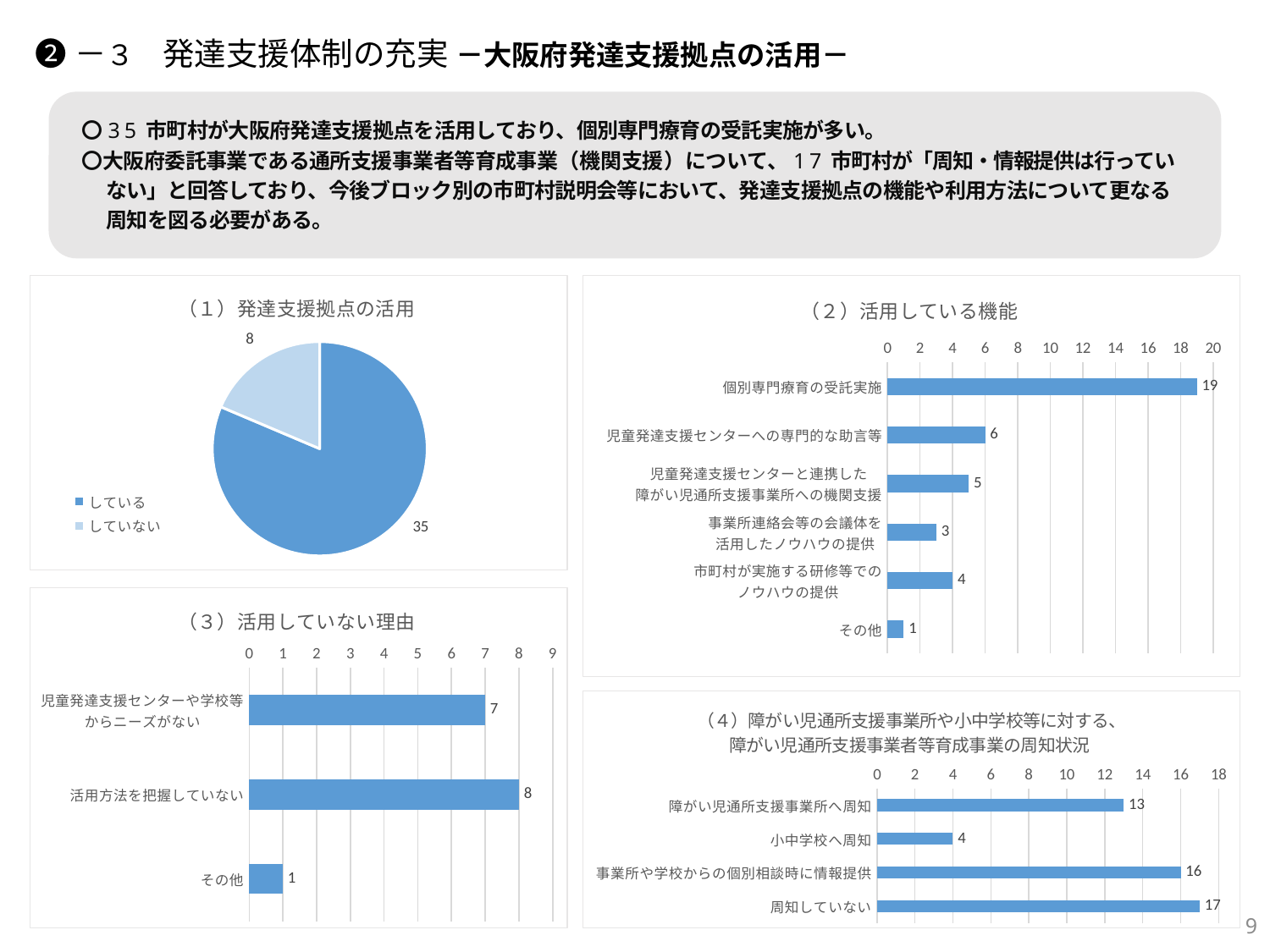
What kind of chart is （３）活用していない理由? Bar chart In the chart titled （４）障がい児通所支援事業所や小中学校等に対する、障がい児通所支援事業者等育成事業の周知状況, which is larger: 障がい児通所支援事業所へ周知 or 小中学校へ周知? 障がい児通所支援事業所へ周知 In the chart titled （２）活用している機能, what is the difference between 児童発達支援センターへの専門的な助言等 and 事業所連絡会等の会議体を活用したノウハウの提供? 3 In the chart titled （４）障がい児通所支援事業所や小中学校等に対する、障がい児通所支援事業者等育成事業の周知状況, what is the value for 周知していない? 17 In the chart titled （１）発達支援拠点の活用, what is the value for している? 35 In the chart titled （３）活用していない理由, which category has the highest value? 活用方法を把握していない In the chart titled （３）活用していない理由, what is the value for 児童発達支援センターや学校等からニーズがない? 7 In the chart titled （２）活用している機能, how many categories are plotted? 6 What kind of chart is （１）発達支援拠点の活用? Pie chart In the chart titled （２）活用している機能, what is the value for 個別専門療育の受託実施? 19 In the chart titled （１）発達支援拠点の活用, what is the value for していない? 8 In the chart titled （２）活用している機能, which category has the lowest value? その他